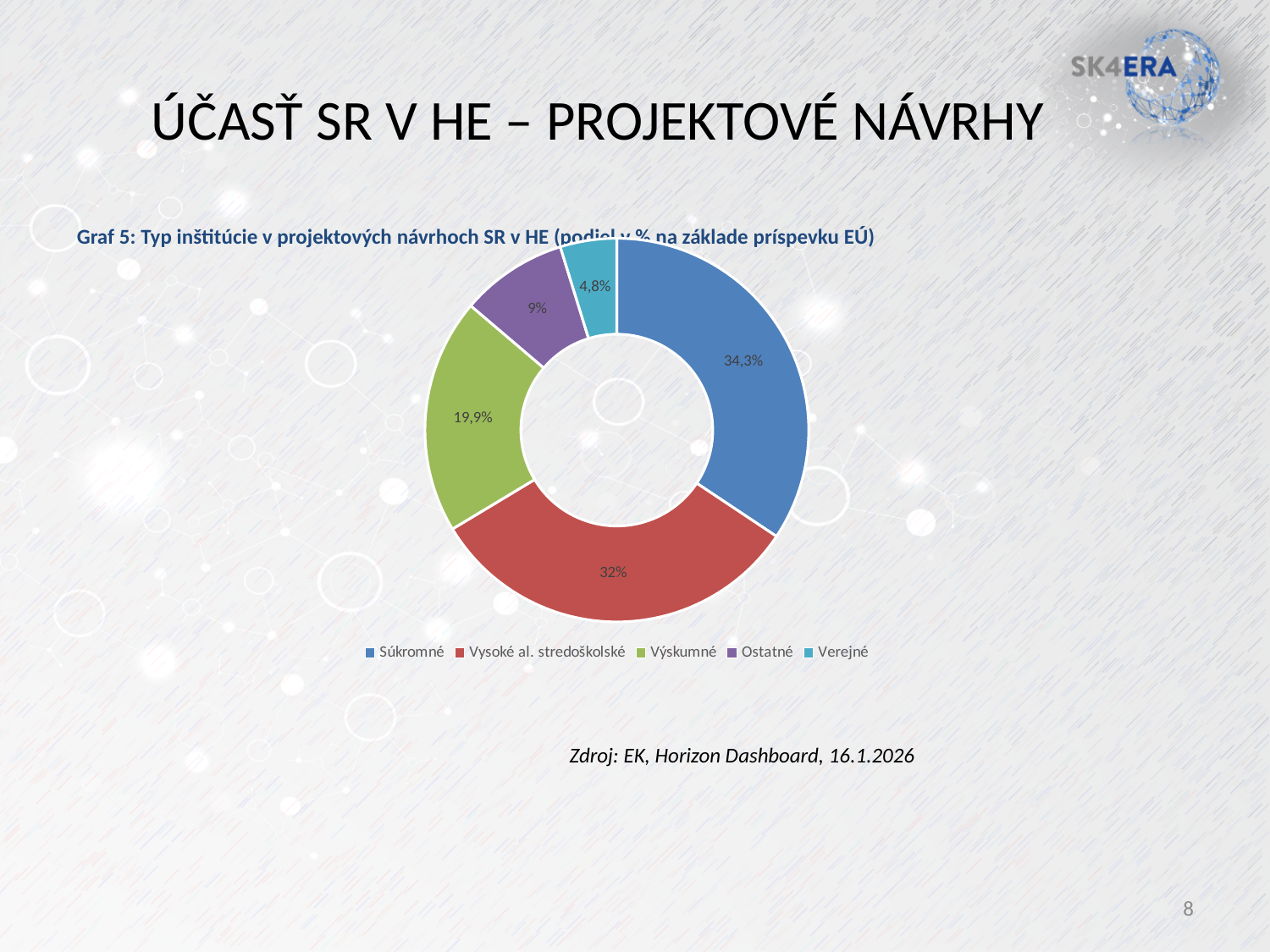
What share of the chart does Súkromné have? 34,3% What is the value for Verejné? 4,8% How many categories does the chart show? 5 Which category has the largest share? Súkromné What is the difference between the shares of Súkromné and Vysoké al. stredoškolské? 2,3% What is the combined share of Ostatné and Verejné? 13,8% What is the value for Výskumné? 19,9% What kind of chart is shown on the slide? Doughnut (pie) chart Which category has the smallest share? Verejné Which colour represents Výskumné in the chart? Green Which is larger, the share of Výskumné or the share of Ostatné? Výskumné What share is shown for Vysoké al. stredoškolské? 32%